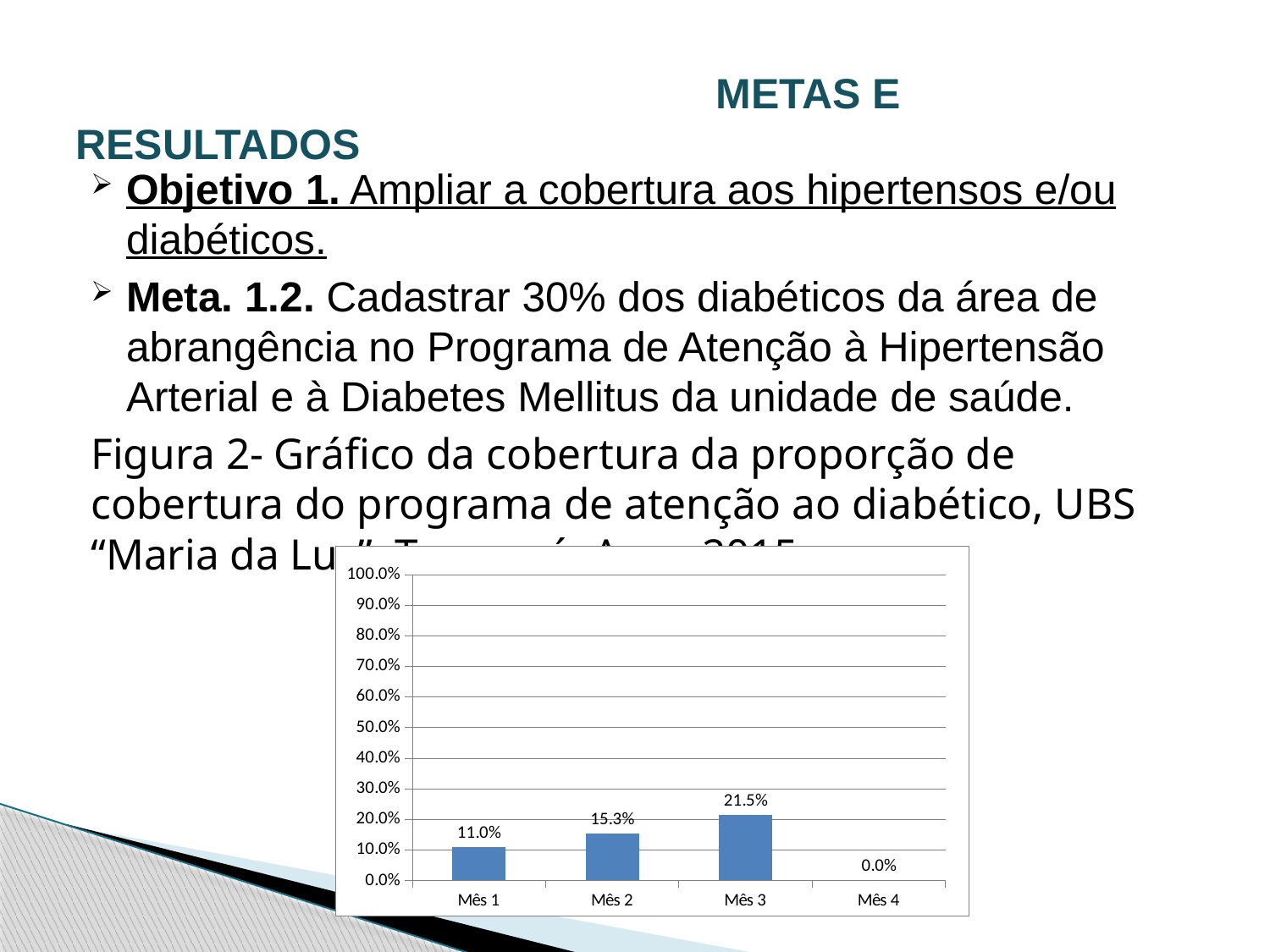
What is the value for Mês 2? 15.3% What is the value for Mês 3? 21.5% What is the difference between the values for Mês 2 and Mês 1? 4.3% Which month has the highest value? Mês 3 Which is larger, the value for Mês 2 or the value for Mês 3? Mês 3 What is the difference between the values for Mês 3 and Mês 1? 10.5% What is the value for Mês 4? 0.0% Is the value for Mês 3 greater or less than 30.0%? less How many months are shown on the x axis of the chart? 4 What kind of chart is shown on the slide? bar chart What is the value for Mês 1? 11.0% Which month has the lowest value? Mês 4